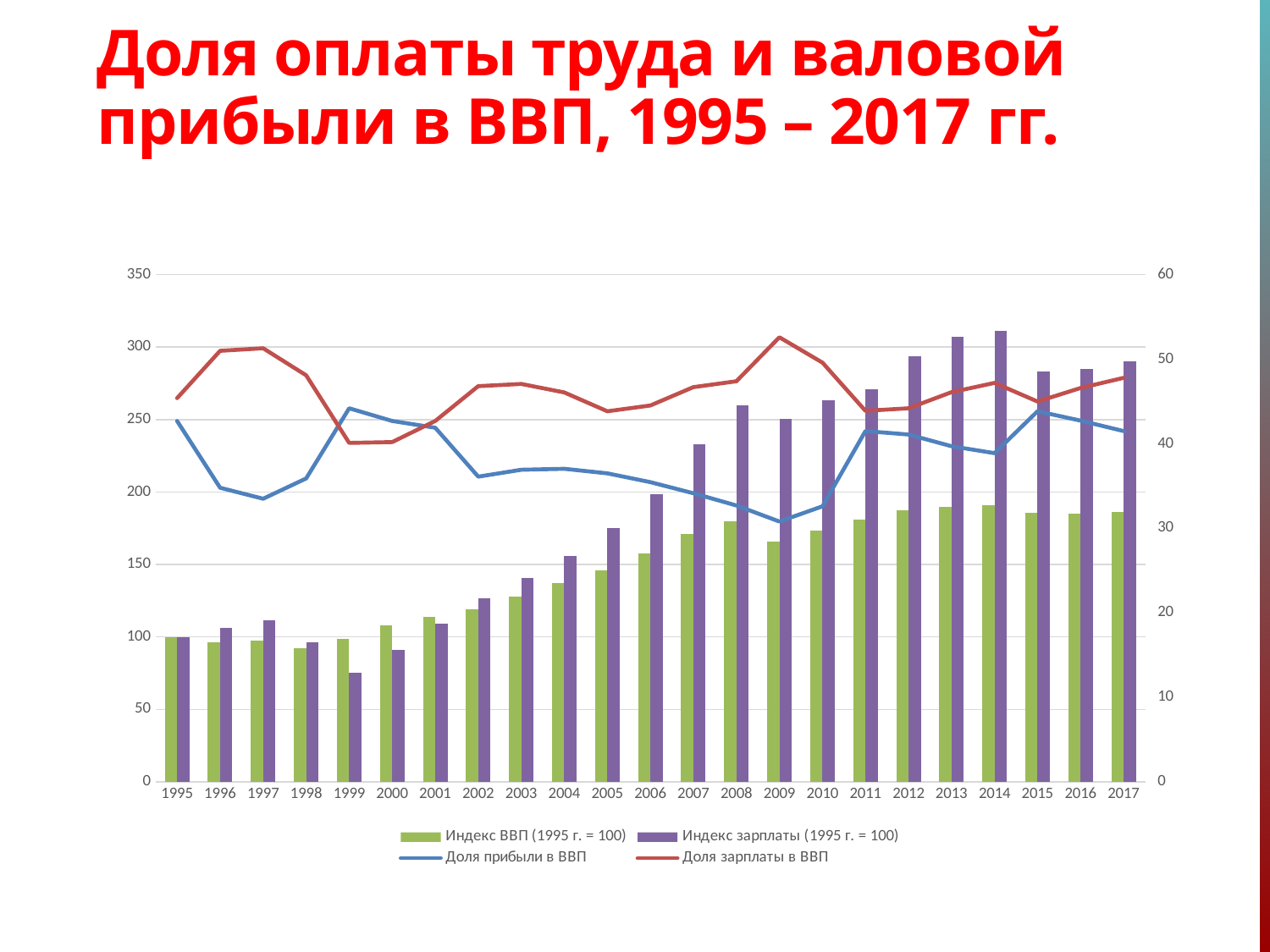
What kind of chart is shown on the slide? A combined bar and line chart How many years are shown along the x axis? 23 Is the Индекс ВВП (1995 г. = 100) value for 2017 greater or less than 200? less In which year is the Индекс зарплаты (1995 г. = 100) bar the highest? 2014 Which colour represents Доля прибыли в ВВП in the chart? Blue How many series does the legend list? 4 Is the Индекс зарплаты (1995 г. = 100) value for 2014 greater or less than 300? greater Is the Доля зарплаты в ВВП value for 2009 greater or less than 50 on the right axis? greater What is the value of Индекс ВВП (1995 г. = 100) in 1995? 100 In 2017, which is larger: Индекс ВВП (1995 г. = 100) or Индекс зарплаты (1995 г. = 100)? Индекс зарплаты (1995 г. = 100) In which year is the Индекс зарплаты (1995 г. = 100) bar the lowest? 1999 Does the Индекс ВВП (1995 г. = 100) series generally rise or fall from 1995 to 2017? Rise